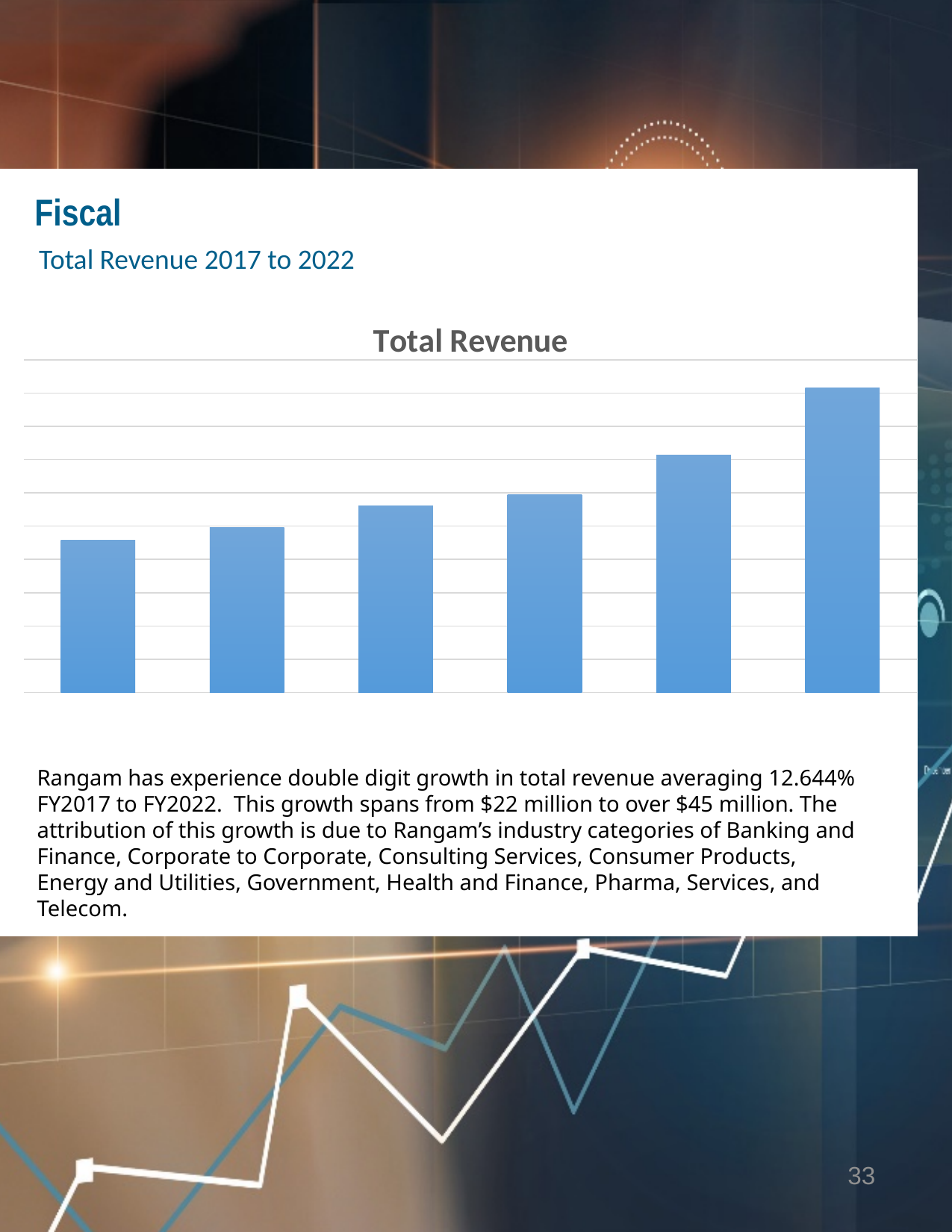
What kind of chart is shown on the slide? Bar chart What colour are the bars in the Total Revenue chart? Blue Does the Total Revenue chart show any bar that is shorter than the bar immediately to its left? No Which bar in the Total Revenue chart is the tallest: the leftmost or the rightmost? The rightmost Do the bars in the Total Revenue chart rise or fall from left to right? Rise What is the title of the chart? Total Revenue In the Total Revenue chart, is the fifth bar from the left taller or shorter than the fourth bar? Taller In the Total Revenue chart, is the second bar from the left taller or shorter than the third bar? Shorter How many bars are plotted in the Total Revenue chart? 6 Which bar in the Total Revenue chart is the shortest: the leftmost or the rightmost? The leftmost